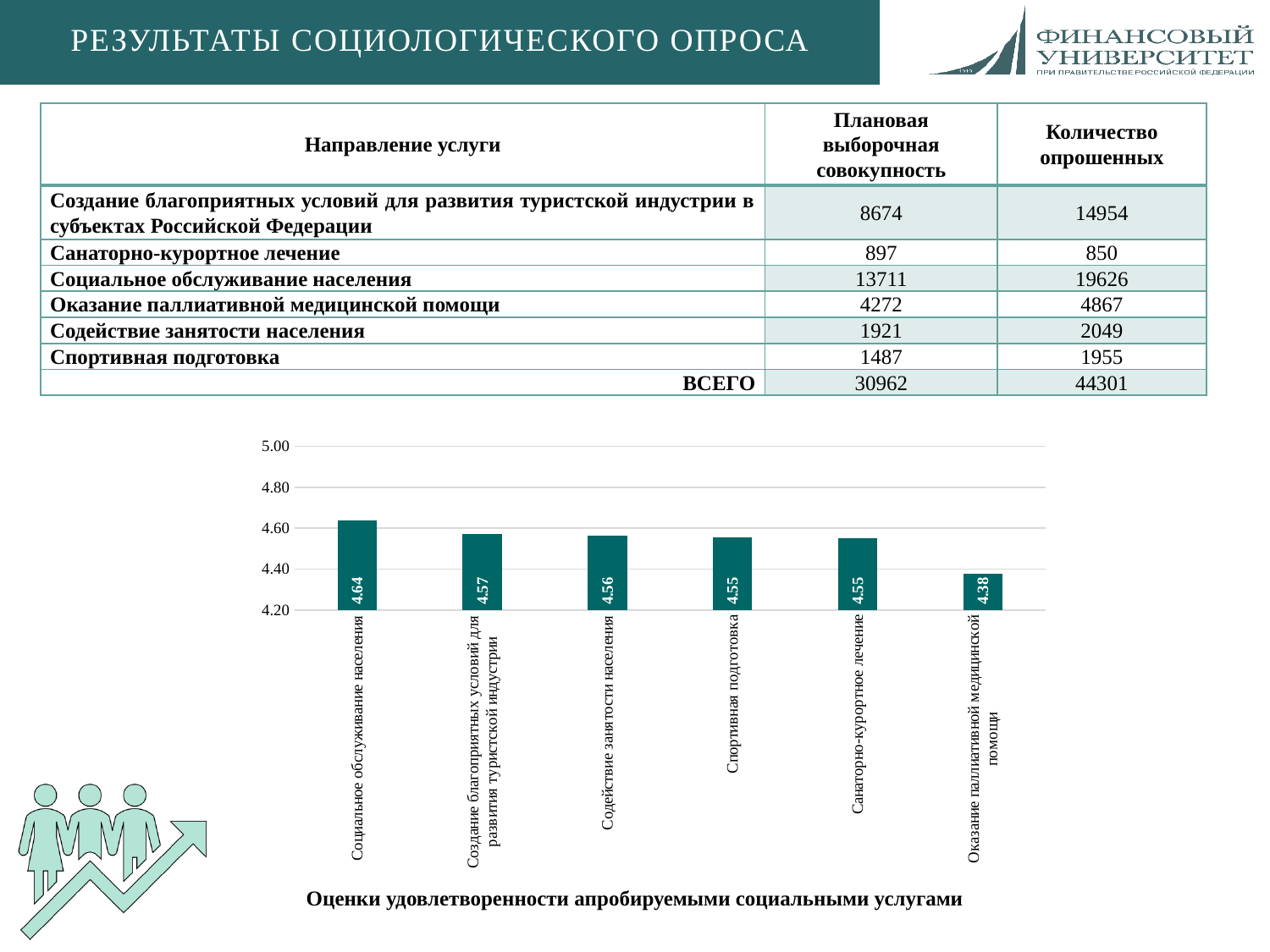
What type of chart is shown on the slide? bar chart Which category has the lowest value in the bar chart? Оказание паллиативной медицинской помощи Which is larger: the value for Содействие занятости населения or the value for Оказание паллиативной медицинской помощи? Содействие занятости населения What is the value for Социальное обслуживание населения in the bar chart? 4.64 What is the difference between the values for Социальное обслуживание населения and Оказание паллиативной медицинской помощи? 0.26 Which category has the highest value in the bar chart? Социальное обслуживание населения What is the caption printed below the bar chart? Оценки удовлетворенности апробируемыми социальными услугами What is the value for Создание благоприятных условий для развития туристской индустрии in the bar chart? 4.57 Is the value for Санаторно-курортное лечение greater or less than 4.40? greater What is the value for Спортивная подготовка in the bar chart? 4.55 How many categories are plotted in the bar chart? 6 What is the value for Оказание паллиативной медицинской помощи in the bar chart? 4.38